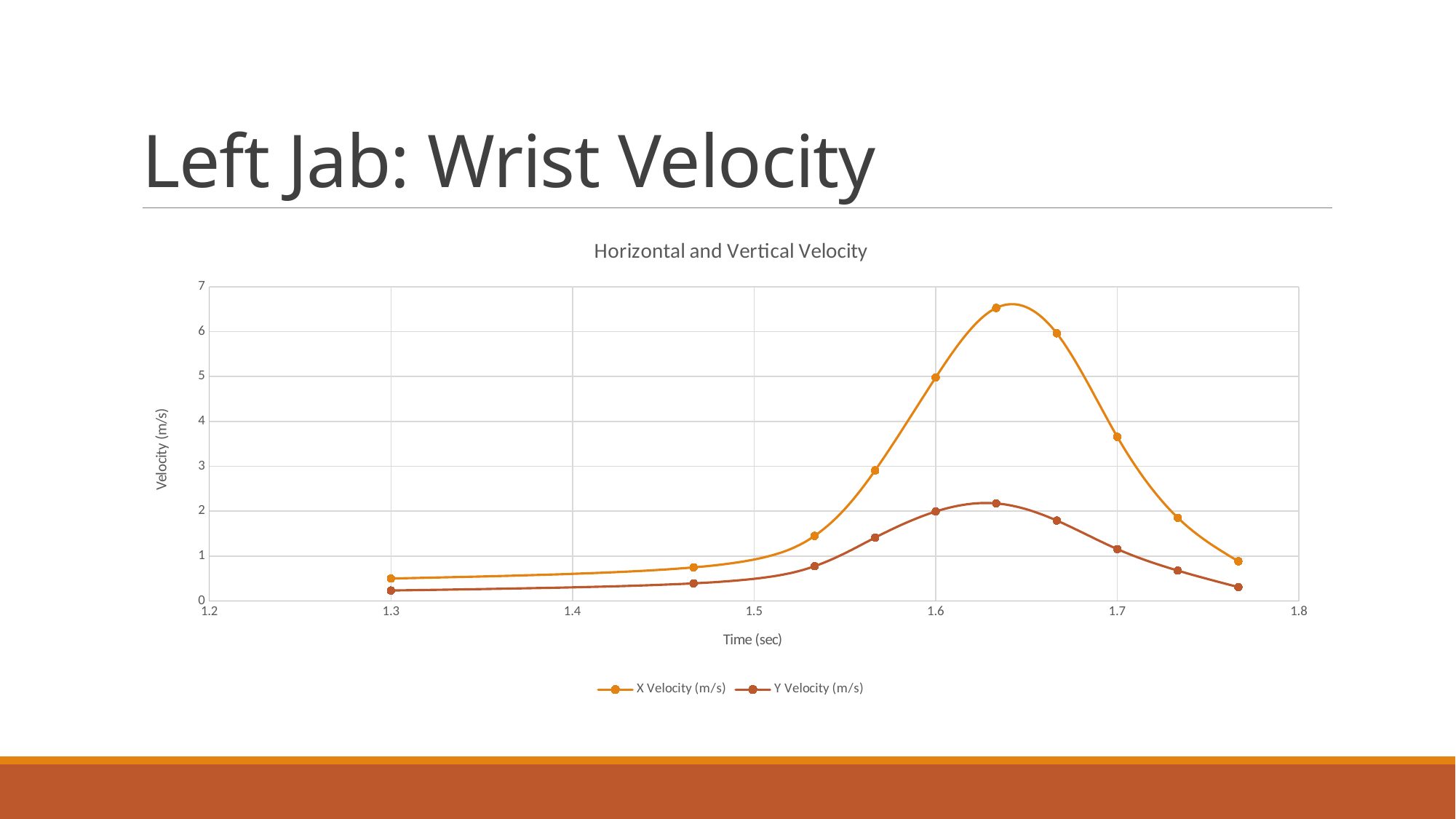
Is the peak value of the Y Velocity (m/s) series greater or less than 3? less What is the label of the vertical axis? Velocity (m/s) Is the peak value of the X Velocity (m/s) series greater or less than 6? greater Which series reaches the higher peak velocity, X Velocity (m/s) or Y Velocity (m/s)? X Velocity (m/s) What kind of chart is shown on the slide? Line chart Is the X Velocity (m/s) value at time 1.3 sec greater or less than 1? less What is the title of the chart? Horizontal and Vertical Velocity At time 1.6 sec, which series has the larger value, X Velocity (m/s) or Y Velocity (m/s)? X Velocity (m/s) Does the Y Velocity (m/s) series rise or fall between time 1.5 sec and 1.6 sec? Rise Does the X Velocity (m/s) series rise or fall between time 1.7 sec and 1.8 sec? Fall How many series does the legend list? 2